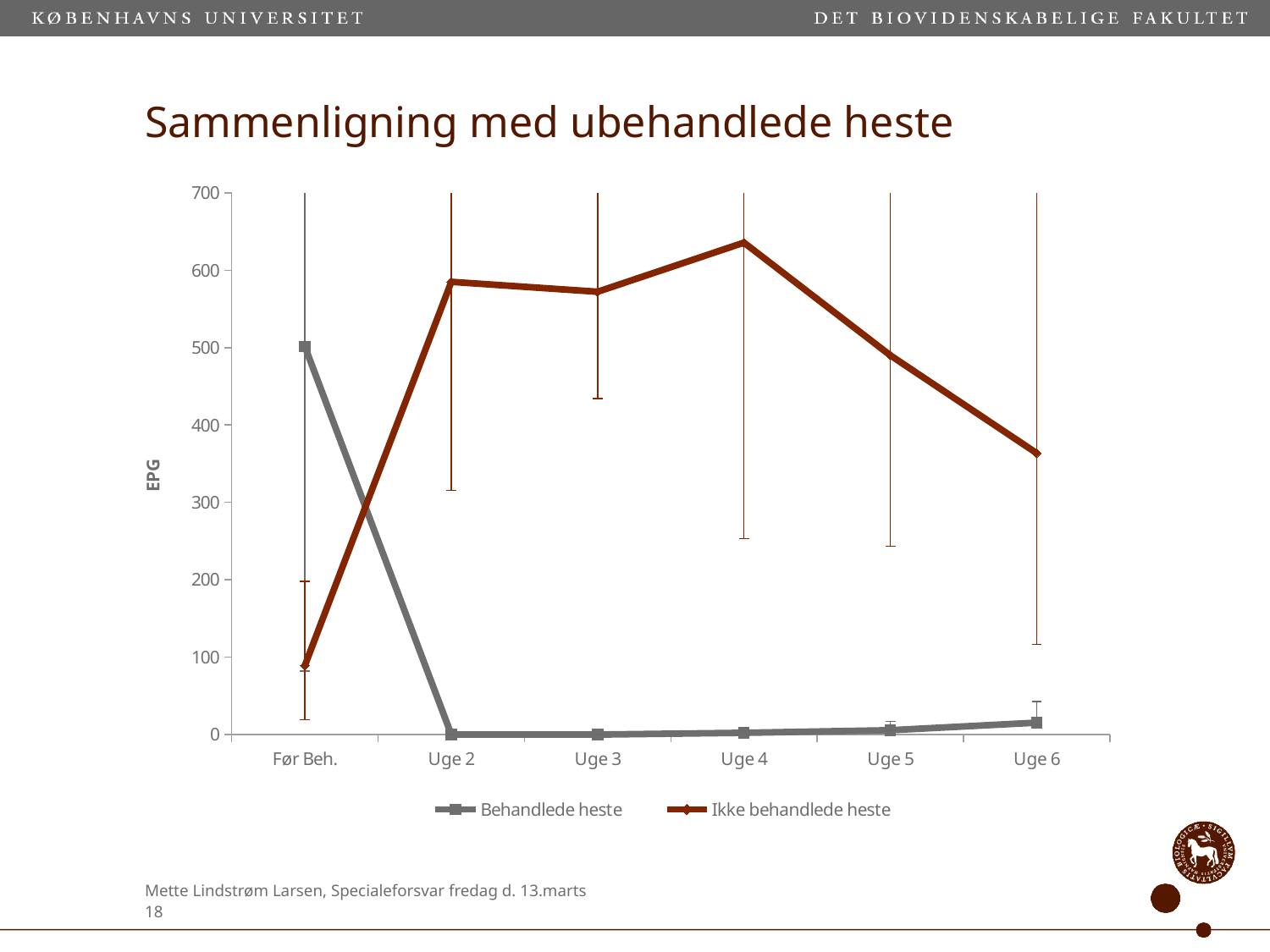
How many series does the legend list? 2 Does the Behandlede heste series rise or fall from Før Beh. to Uge 2? fall Which series has the larger value at Uge 2, Behandlede heste or Ikke behandlede heste? Ikke behandlede heste What is the title of the slide's chart? Sammenligning med ubehandlede heste Is the value for Ikke behandlede heste at Uge 4 greater or less than 600? greater What kind of chart is shown on the slide? line chart At which category does the Behandlede heste series have its highest value? Før Beh. Is the value for Ikke behandlede heste at Før Beh. greater or less than 100? less How many categories are shown on the x axis? 6 What is the label of the y axis? EPG At which category does the Ikke behandlede heste series have its lowest value? Før Beh. At which category does the Ikke behandlede heste series reach its highest value? Uge 4